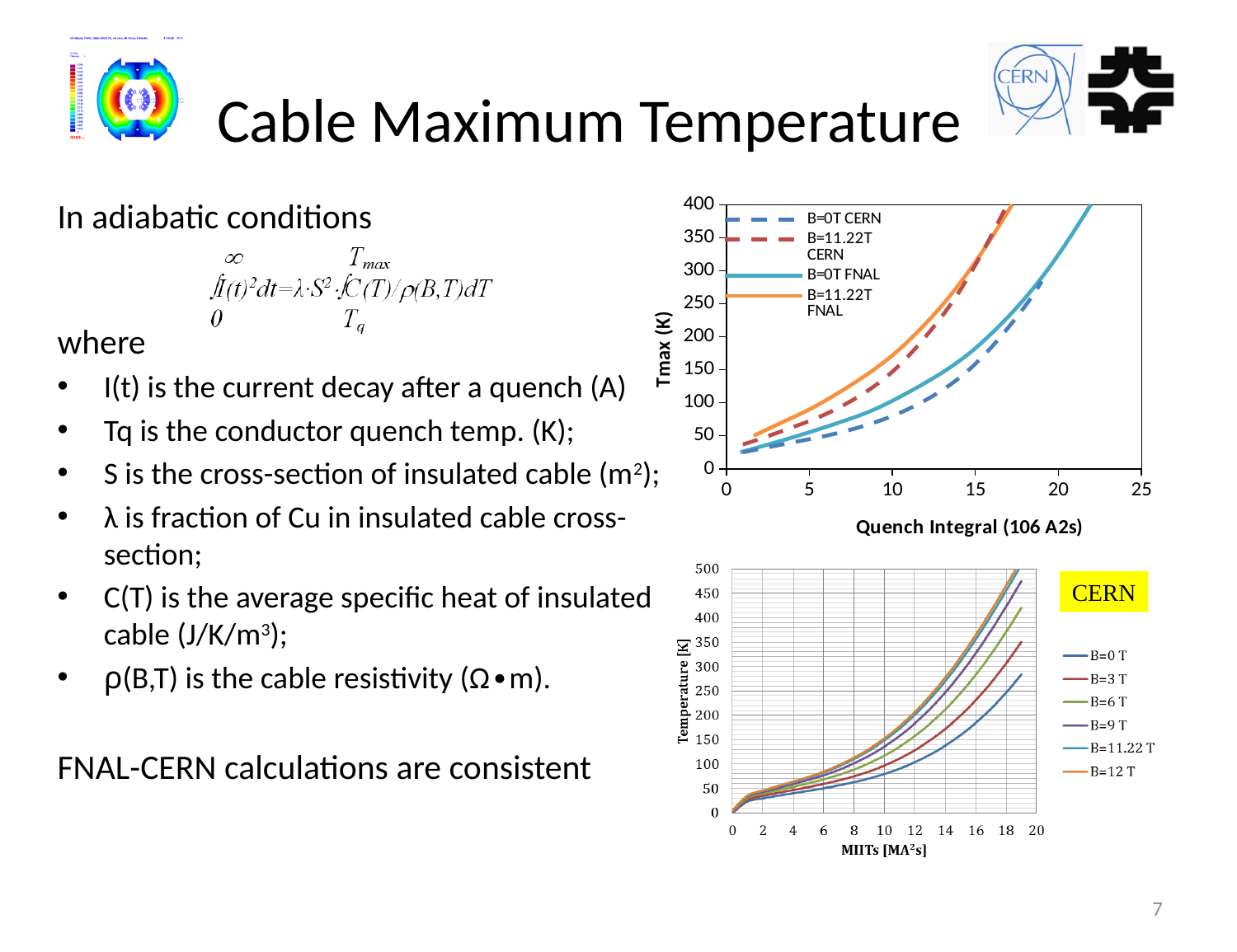
In the top chart (Tmax vs Quench Integral), at a quench integral of 10, which is larger: B=11.22T FNAL or B=0T FNAL? B=11.22T FNAL How many series does the legend of the top chart (Tmax vs Quench Integral) list? 4 In the top chart (Tmax vs Quench Integral), do the Tmax values rise or fall as the quench integral increases? rise In the top chart (Tmax vs Quench Integral), which series has the lowest Tmax at a quench integral of 10? B=0T CERN In the bottom chart (Temperature vs MIITs), which series has the highest temperature at 18 MIITs? B=12 T What kind of chart is the top chart (Tmax vs Quench Integral)? line chart What is the x-axis label of the top chart (Tmax vs Quench Integral)? Quench Integral (106 A2s) How many series does the legend of the bottom chart (Temperature vs MIITs) list? 6 In the top chart (Tmax vs Quench Integral), is the value for B=11.22T FNAL at a quench integral of 15 greater or less than 200? greater In the bottom chart (Temperature vs MIITs), is the value for B=0 T at 10 MIITs greater or less than 100? less In the bottom chart (Temperature vs MIITs), is the value for B=12 T at 18 MIITs greater or less than 400? greater